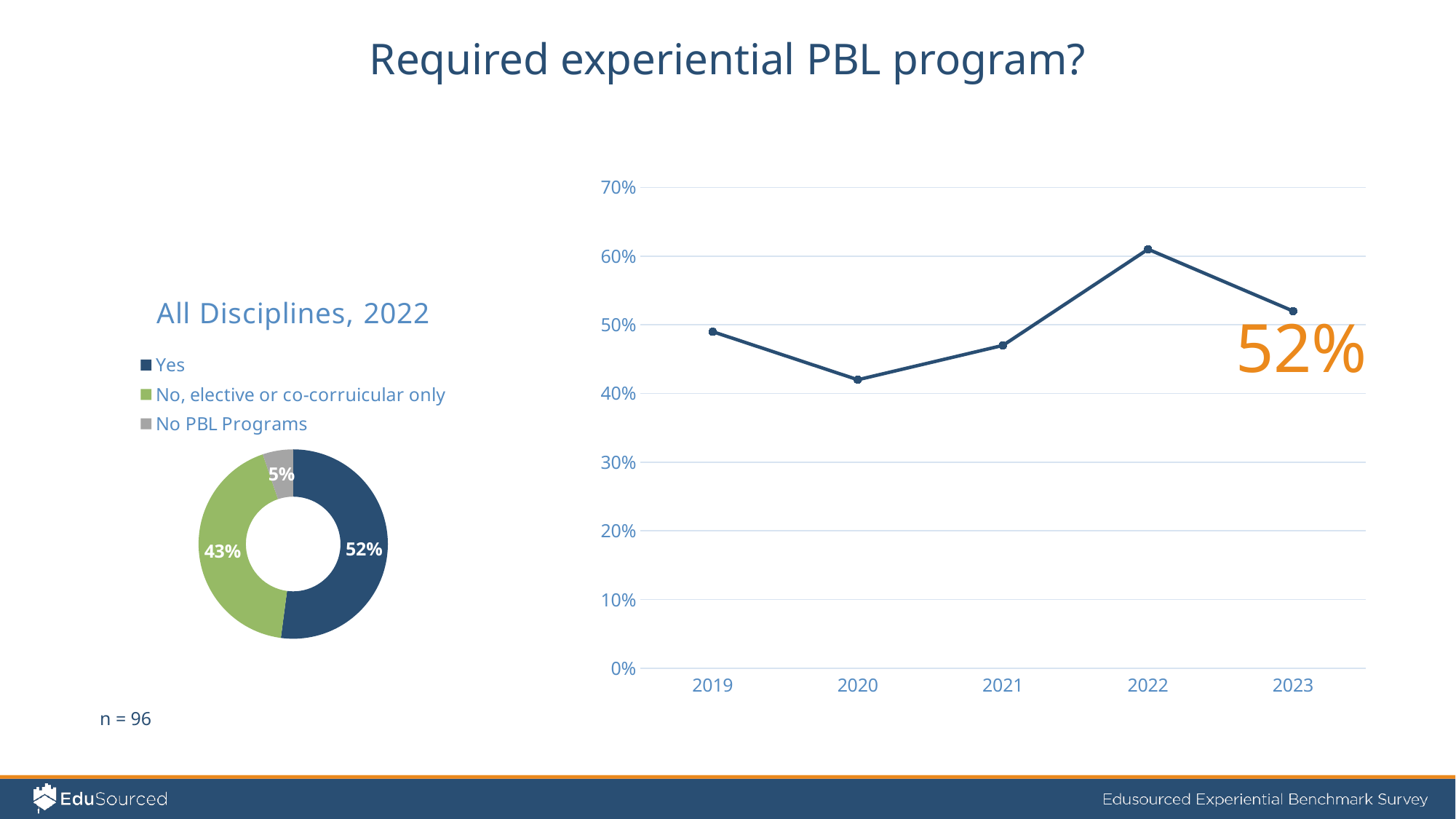
In the donut chart titled 'All Disciplines, 2022', what percentage is shown for 'No, elective or co-corruicular only'? 43% In the line chart on the right, which year has the highest value? 2022 In the donut chart titled 'All Disciplines, 2022', which category has the smallest share? No PBL Programs In the donut chart titled 'All Disciplines, 2022', what percentage is shown for 'No PBL Programs'? 5% In the donut chart titled 'All Disciplines, 2022', what percentage is shown for 'Yes'? 52% In the line chart on the right, what value is labeled for 2023? 52% In the donut chart titled 'All Disciplines, 2022', which category has the largest share? Yes How many categories does the legend of the donut chart titled 'All Disciplines, 2022' list? 3 In the line chart on the right, how many years are plotted on the x axis? 5 In the line chart on the right, which year has the lowest value? 2020 In the donut chart titled 'All Disciplines, 2022', what is the difference in percentage points between 'Yes' and 'No, elective or co-corruicular only'? 9